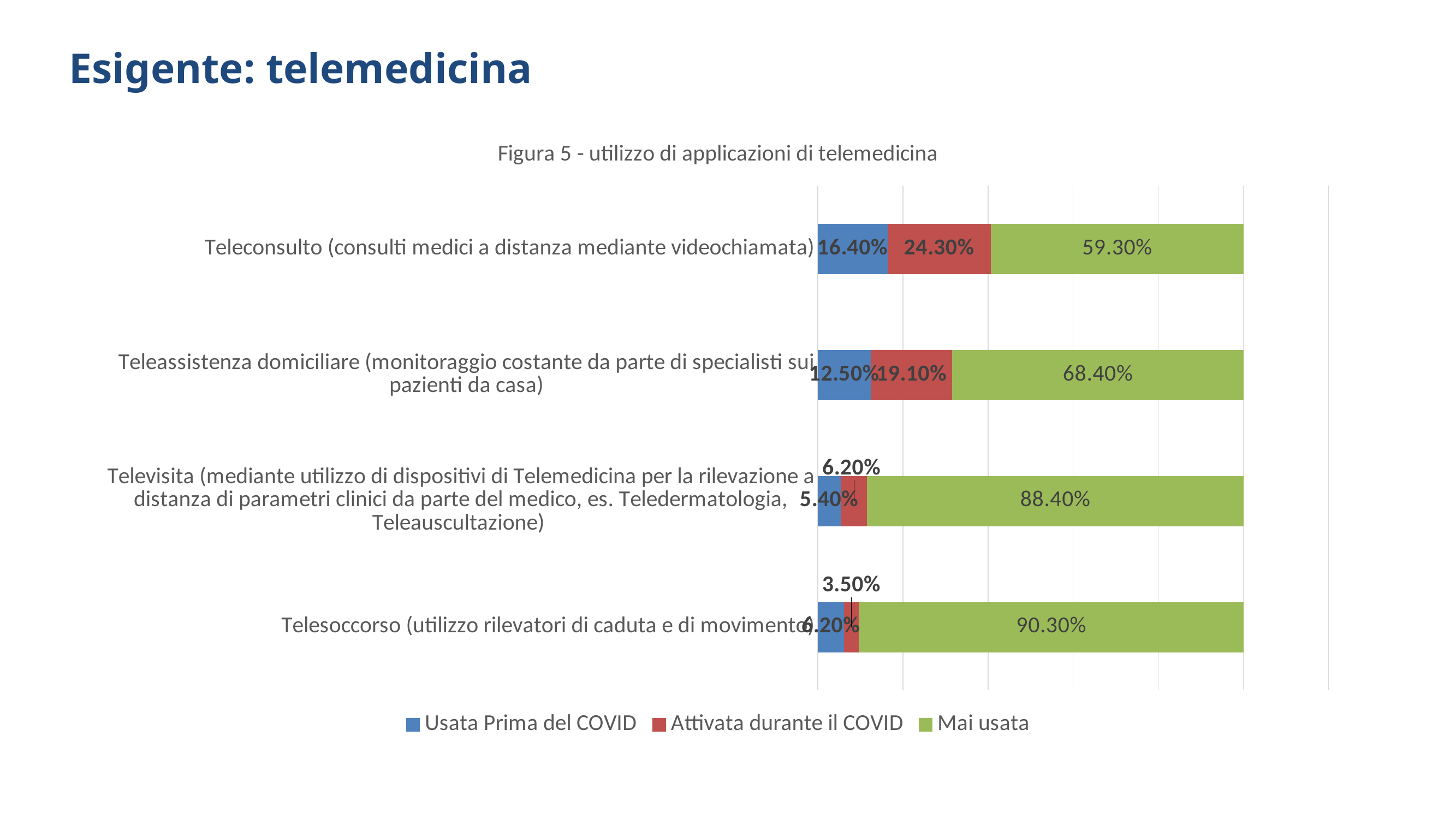
What is the 'Mai usata' value for Televisita? 88.40% Which has a larger 'Usata Prima del COVID' value, Teleconsulto or Teleassistenza domiciliare? Teleconsulto What is the 'Mai usata' value for Teleconsulto? 59.30% What is the difference between the 'Attivata durante il COVID' values for Teleconsulto and Teleassistenza domiciliare? 5.20% Which category has the highest 'Mai usata' value? Telesoccorso How many categories (telemedicine applications) are plotted in the chart? 4 How many series does the legend list? 3 What is the 'Attivata durante il COVID' value for Teleassistenza domiciliare? 19.10% What is the 'Usata Prima del COVID' value for Teleconsulto? 16.40% What is the 'Attivata durante il COVID' value for Telesoccorso? 3.50% Which category has the lowest 'Mai usata' value? Teleconsulto What kind of chart is shown on the slide? Stacked bar chart